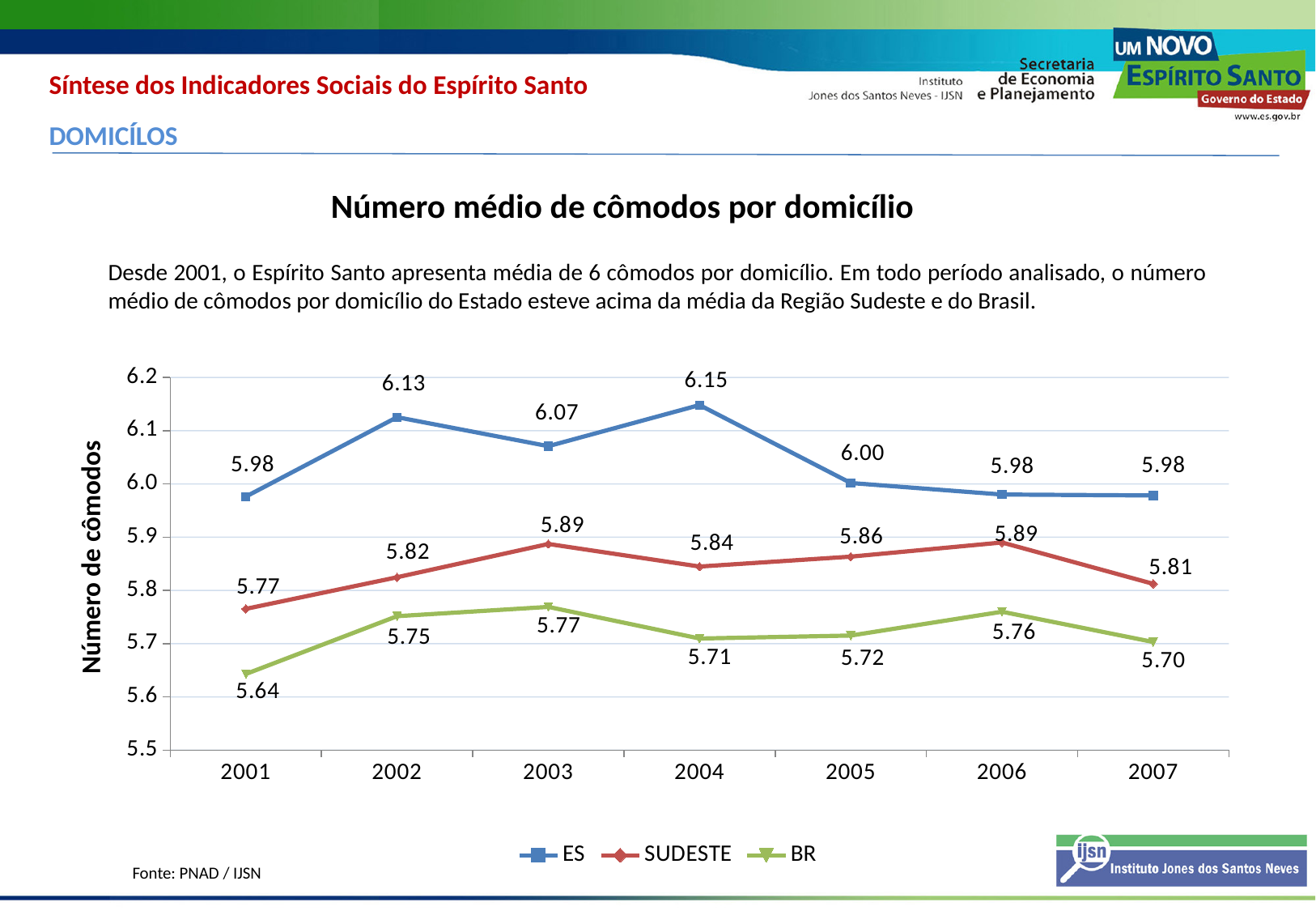
What is the value for BR in 2001? 5.64 What is the difference between the ES and BR values in 2007? 0.28 What is the value for SUDESTE in 2003? 5.89 In which year does the ES series reach its highest value? 2004 What is the label of the y axis? Número de cômodos How many series does the legend list? 3 How many years are shown on the x axis? 7 In which year does the BR series have its lowest value? 2001 What type of chart is shown on the slide? Line chart What is the value for ES in 2004? 6.15 Which series has the higher value in 2005, SUDESTE or BR? SUDESTE Is the value for ES in 2002 greater or less than 6.1? greater